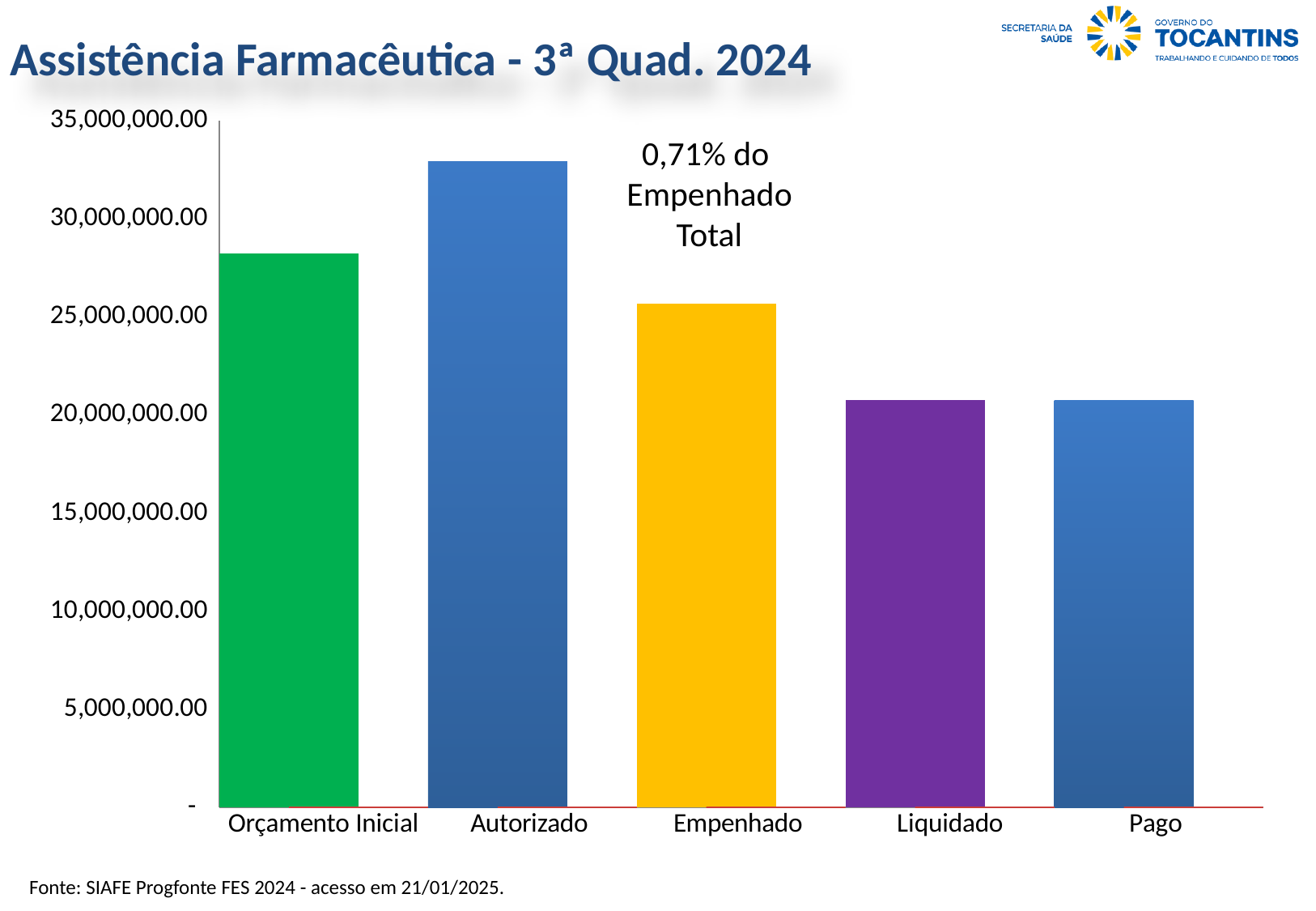
Is the value for Autorizado greater or less than 30,000,000.00? greater What is the title of the slide? Assistência Farmacêutica - 3ª Quad. 2024 What percentage of the Empenhado Total does the annotation above the Empenhado bar state? 0,71% What kind of chart is shown on the slide? bar chart Is the value for Empenhado greater or less than 25,000,000.00? greater Which is larger, the value for Autorizado or the value for Liquidado? Autorizado Is the value for Pago greater or less than 20,000,000.00? greater Which is larger, the value for Orçamento Inicial or the value for Empenhado? Orçamento Inicial How many categories are plotted on the x axis? 5 Which category has the highest value? Autorizado